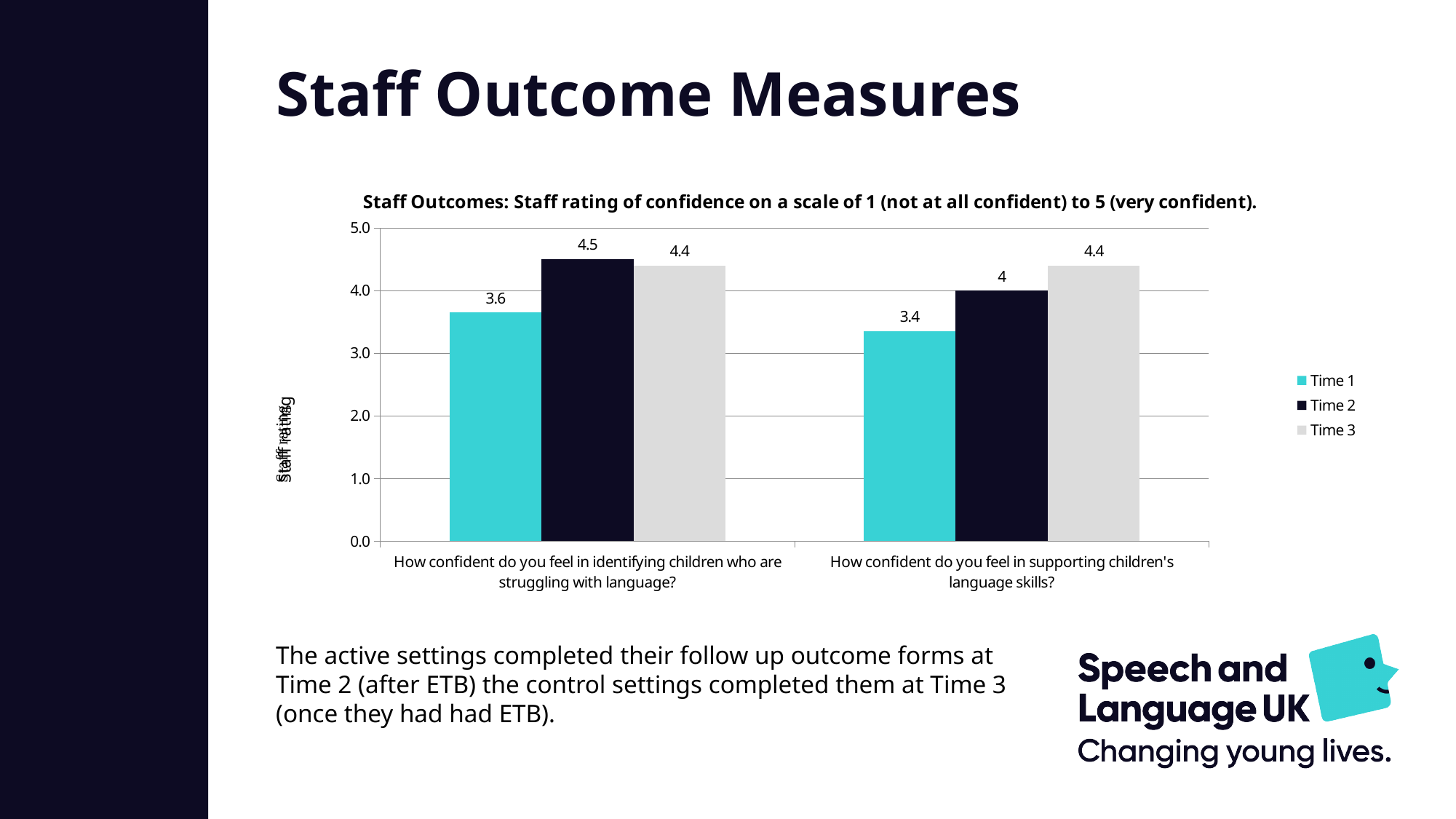
Which time point has the lowest rating for "How confident do you feel in supporting children's language skills?" Time 1 What kind of chart is shown on the slide? Bar chart Which time point has the highest rating for "How confident do you feel in identifying children who are struggling with language?" Time 2 How many question categories are shown on the x axis? 2 What is the Time 2 value for "How confident do you feel in supporting children's language skills?" 4 Which is larger: the Time 2 rating for identifying children struggling with language, or the Time 2 rating for supporting children's language skills? Identifying children struggling with language What is the difference between the Time 2 and Time 1 ratings for "How confident do you feel in identifying children who are struggling with language?" 0.9 What is the Time 3 value for "How confident do you feel in identifying children who are struggling with language?" 4.4 What is the Time 1 value for "How confident do you feel in identifying children who are struggling with language?" 3.6 What is the difference between the Time 3 and Time 1 ratings for "How confident do you feel in supporting children's language skills?" 1 What colour are the Time 1 bars? Turquoise How many series does the legend list? 3